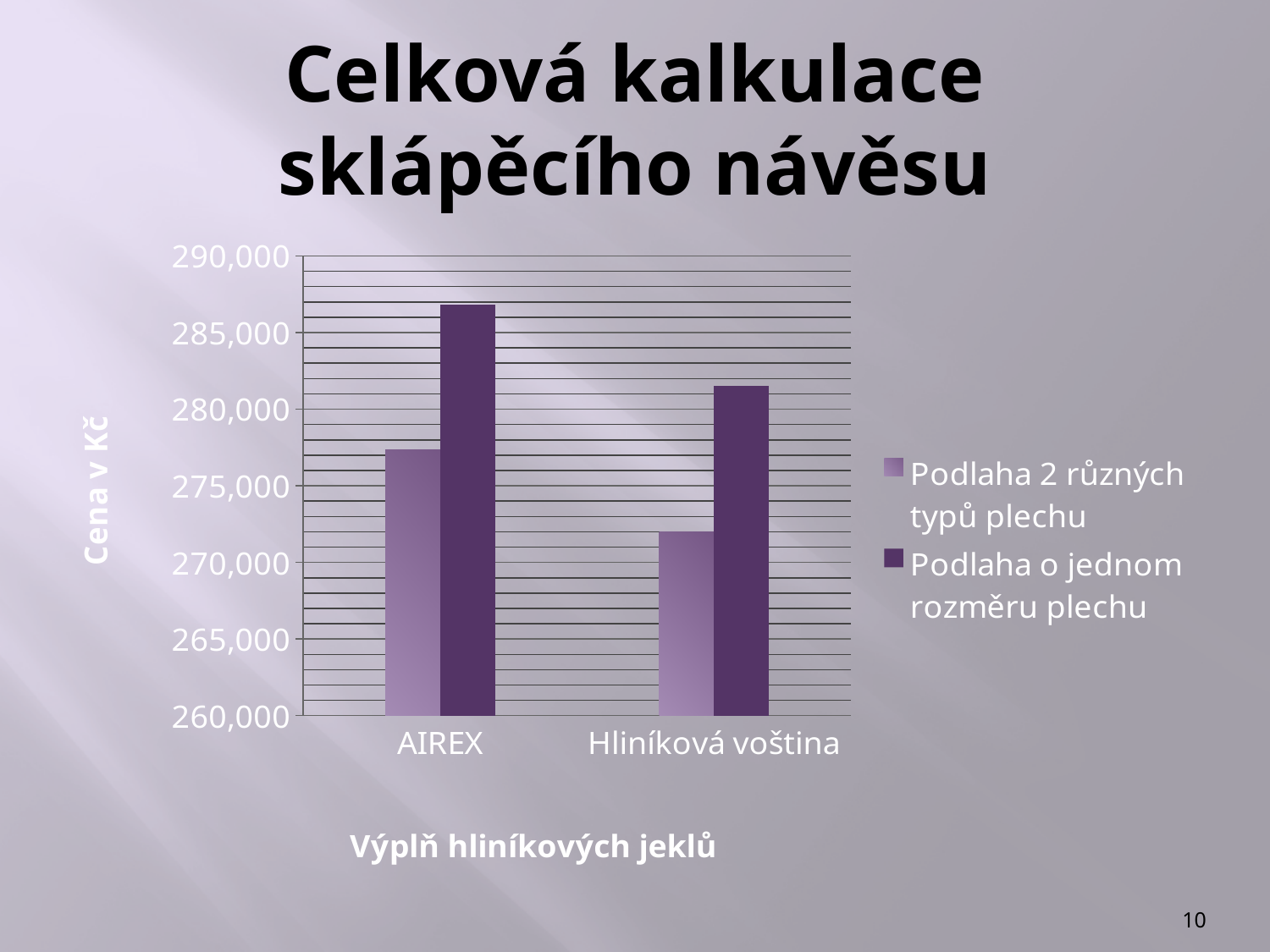
Which bar is the tallest in the whole chart? AIREX, Podlaha o jednom rozměru plechu What is the title of the vertical axis of the chart? Cena v Kč Is the value for AIREX in the series 'Podlaha o jednom rozměru plechu' greater or less than 285,000? greater How many series does the chart's legend list? 2 Is the value for Hliníková voština in the series 'Podlaha 2 různých typů plechu' greater or less than 275,000? less For the category AIREX, which series has the larger value: 'Podlaha 2 různých typů plechu' or 'Podlaha o jednom rozměru plechu'? Podlaha o jednom rozměru plechu Is the value for AIREX in the series 'Podlaha 2 různých typů plechu' greater or less than 275,000? greater Which category has the highest bar for the series 'Podlaha o jednom rozměru plechu'? AIREX What kind of chart is shown on the slide? bar chart Which category has the lowest bar for the series 'Podlaha 2 různých typů plechu'? Hliníková voština How many categories are shown on the x axis of the chart? 2